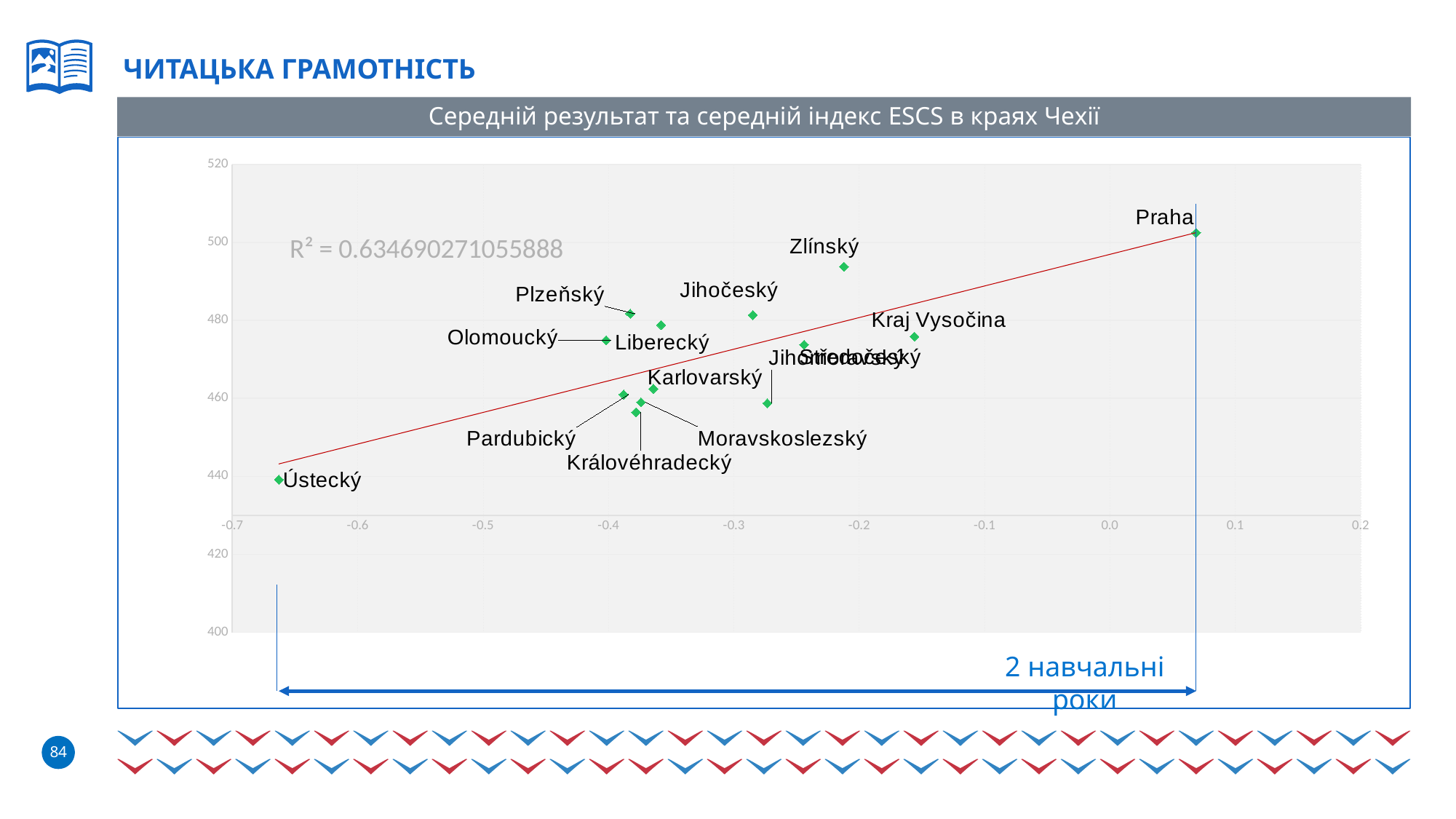
Is the value for Ústecký greater or less than 460? less What is the title of the chart? Середній результат та середній індекс ESCS в краях Чехії Does the trendline rise or fall as the ESCS index increases along the x axis? rises Is the value for Karlovarský greater or less than 480? less Is the value for Praha greater or less than 480? greater Which has the higher average result, Zlínský or Pardubický? Zlínský What kind of chart is shown on the slide? scatter chart Which region has the highest average result on the chart? Praha What R² value is printed on the chart? R² = 0.634690271055888 Which has the higher average result, Jihočeský or Královéhradecký? Jihočeský Which region has the lowest average result on the chart? Ústecký